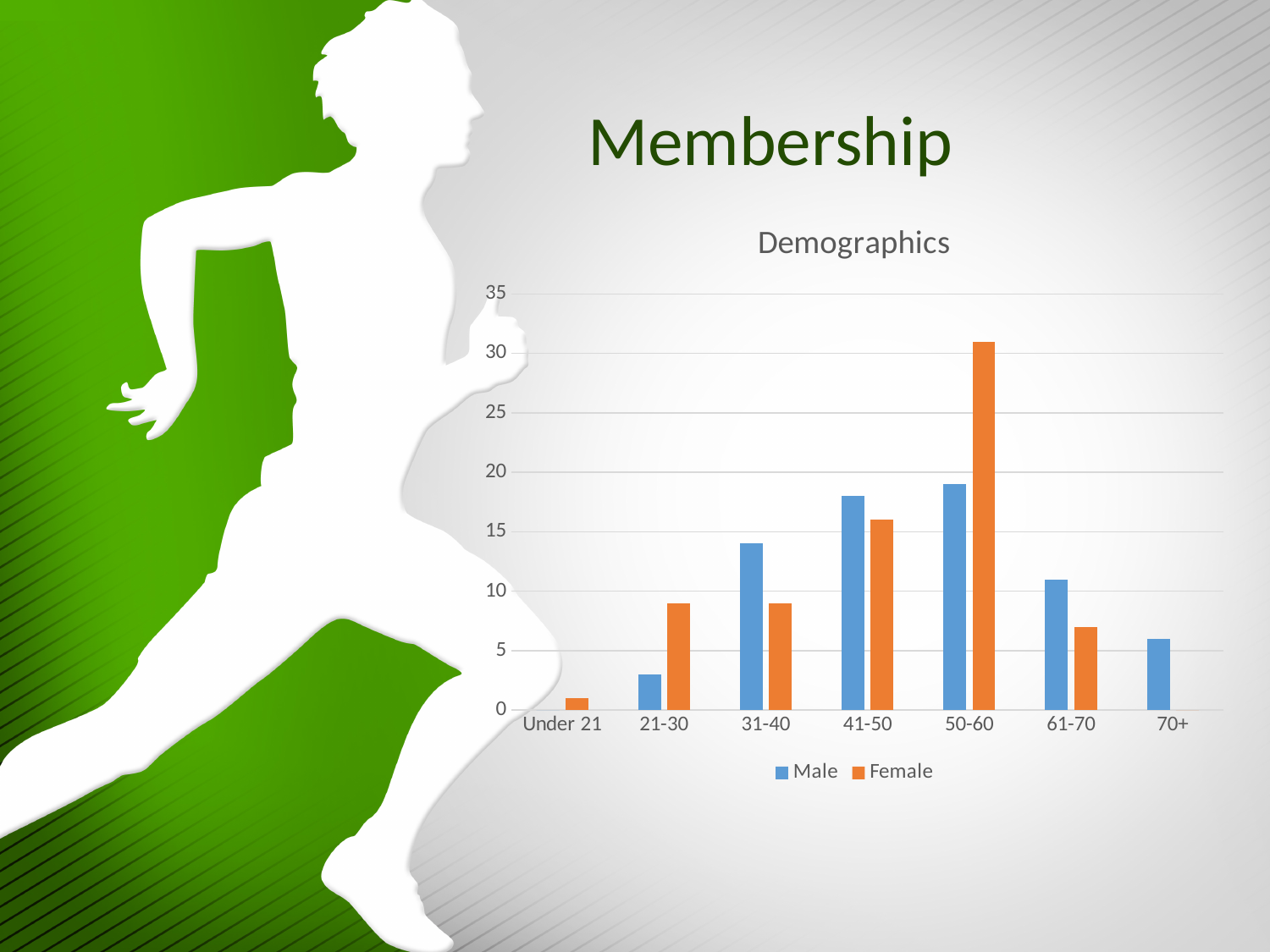
Which age group has the highest Female value? 50-60 Is the Male value for 21-30 greater or less than 5? less Is the Male value for 31-40 greater or less than 10? greater What kind of chart is shown on the slide? bar chart For the 31-40 age group, which is larger, Male or Female? Male How many age categories are shown on the x axis? 7 How many series does the legend list? 2 Is the Female value for 61-70 greater or less than 10? less For the 50-60 age group, which is larger, Male or Female? Female What is the title of the chart? Demographics